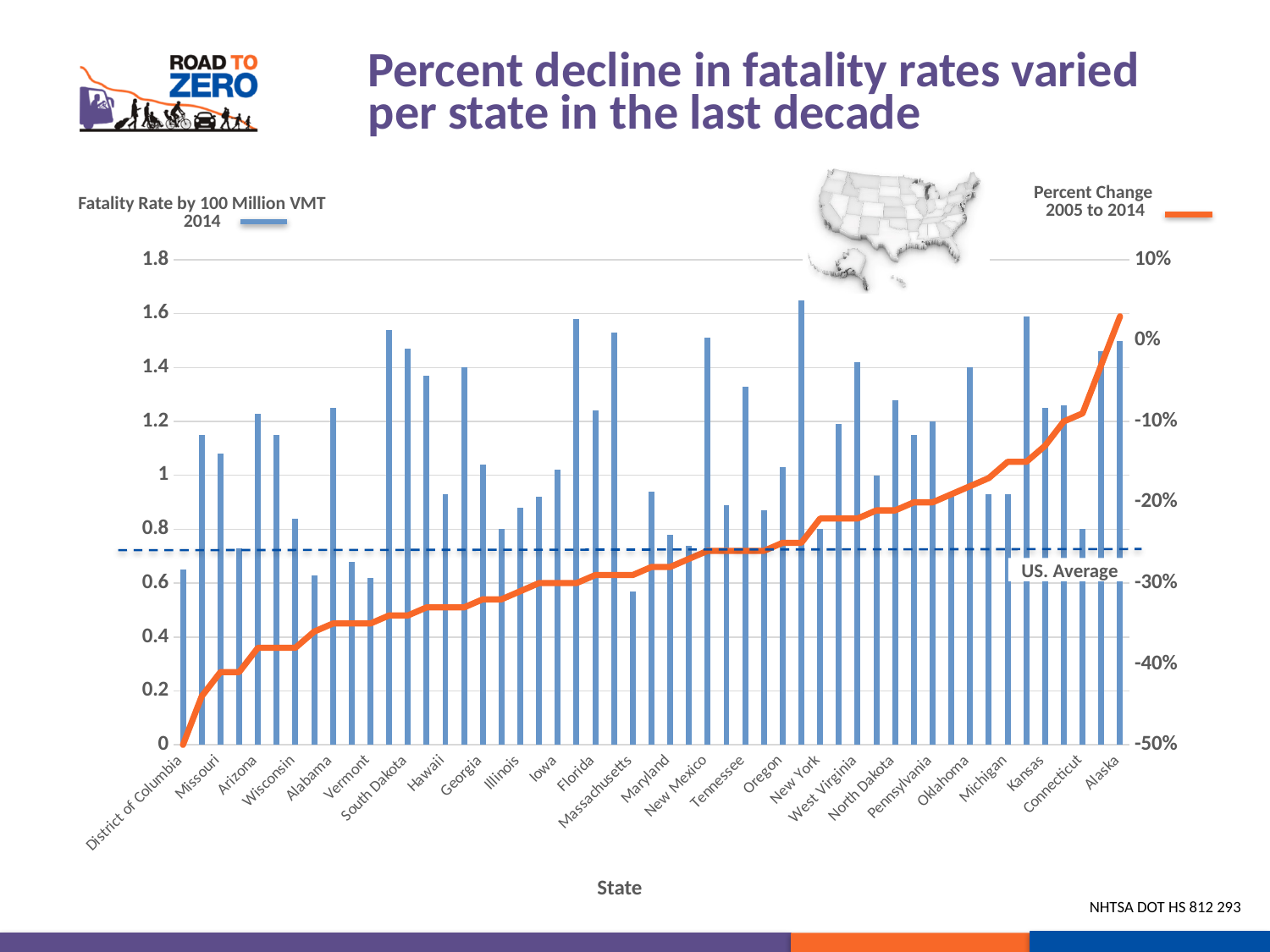
Is the 2014 fatality rate bar for Alaska greater or less than 1.2? greater Is the 2014 fatality rate bar for District of Columbia greater or less than 0.8? less What kind of chart is shown on the slide? A combined bar and line chart Is the Percent Change 2005 to 2014 value for Alaska greater or less than 0%? greater How many state labels are shown on the x axis of the chart? 26 Which has the higher 2014 fatality rate bar, District of Columbia or Alaska? Alaska Does the Percent Change 2005 to 2014 line rise or fall moving from District of Columbia to Alaska along the x axis? Rises What does the orange line in the chart represent? Percent Change 2005 to 2014 How many series does the chart's legend list? 2 What does the blue dashed horizontal line across the chart represent? US. Average